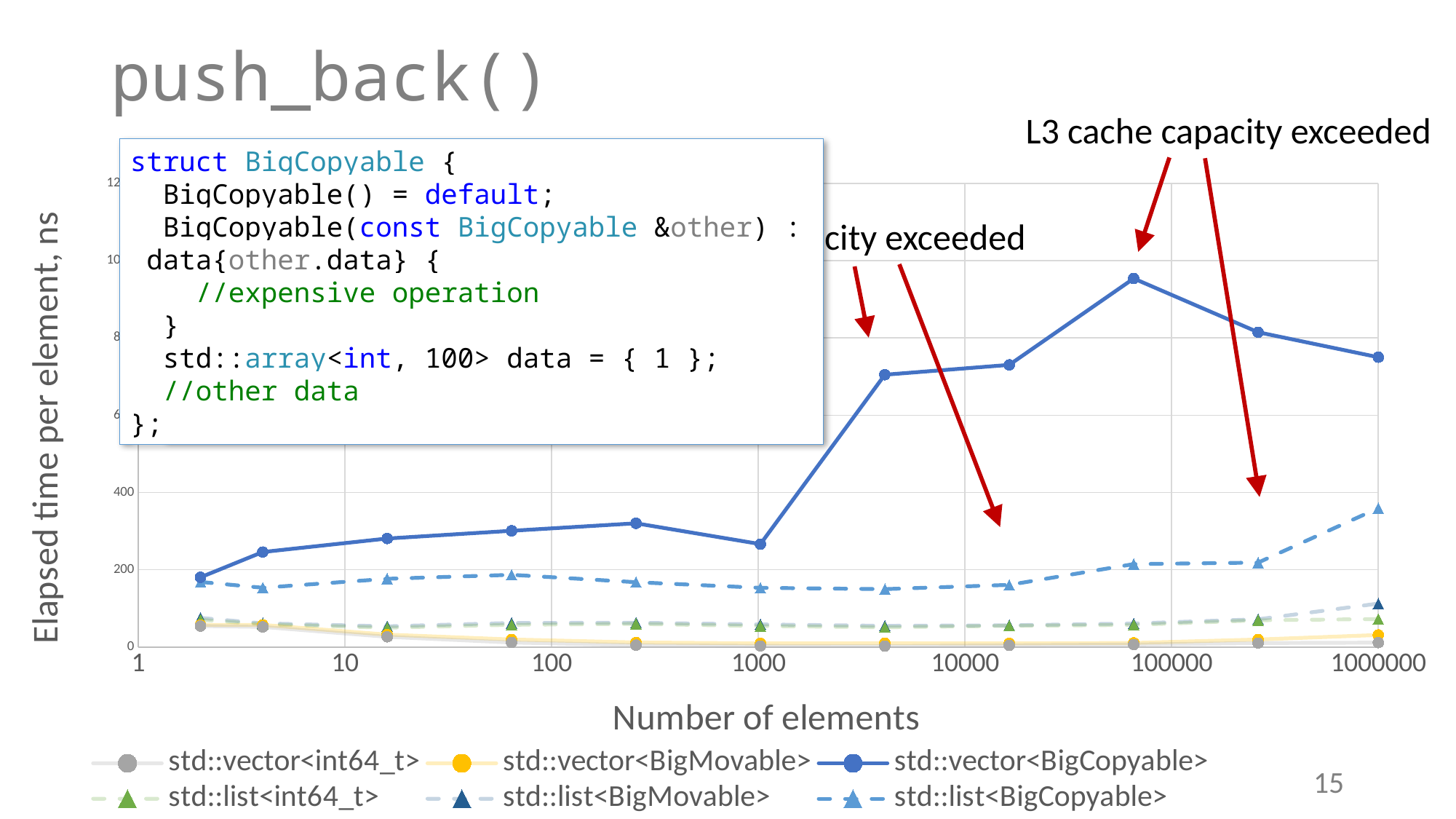
Is the value for std::vector<BigCopyable> at 1000 elements greater or less than 200? greater At 1000000 elements, which is larger: std::vector<BigCopyable> or std::list<BigCopyable>? std::vector<BigCopyable> What is the title of the y axis of the chart? Elapsed time per element, ns Does the std::list<BigCopyable> series rise or fall between 10000 and 1000000 elements? rise Which series reaches the highest elapsed time per element on the chart? std::vector<BigCopyable> Is the value for std::vector<int64_t> at 1000000 elements greater or less than 200? less What kind of chart is shown on the slide? line chart Is the value for std::vector<BigCopyable> at 1000000 elements greater or less than 400? greater What is the title of the x axis of the chart? Number of elements How many series does the chart legend list? 6 How many data points are plotted for the std::vector<BigCopyable> series? 11